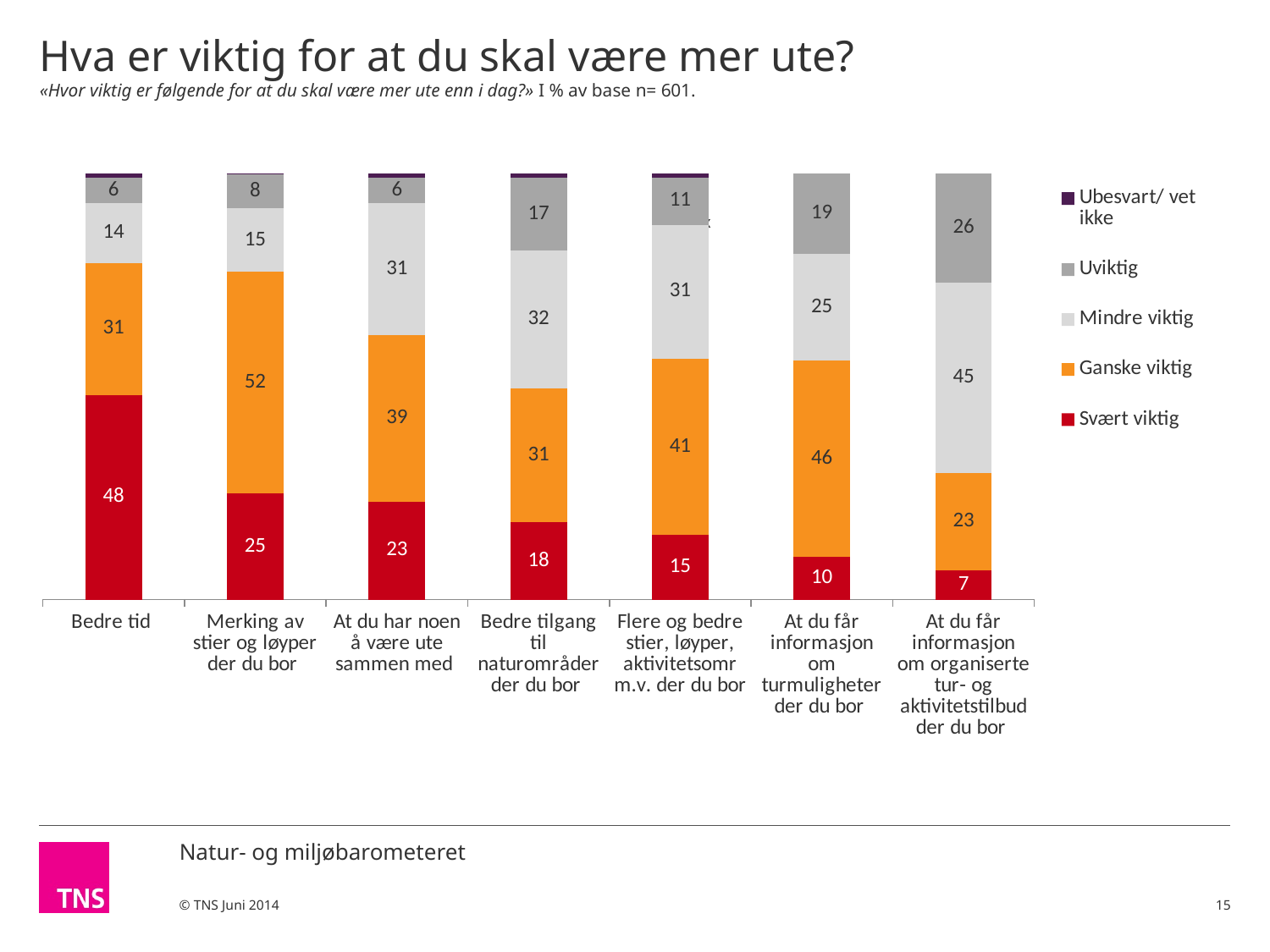
What is the difference between the 'Svært viktig' values for 'Bedre tid' and 'Merking av stier og løyper der du bor'? 23 Which series is shown in red in the legend? Svært viktig Which category has the highest 'Svært viktig' value? Bedre tid Which category has the lowest 'Svært viktig' value? At du får informasjon om organiserte tur- og aktivitetstilbud der du bor What kind of chart is shown on the slide? Stacked bar chart Which is larger: the 'Ganske viktig' value for 'Flere og bedre stier, løyper, aktivitetsomr m.v. der du bor' or for 'At du får informasjon om turmuligheter der du bor'? At du får informasjon om turmuligheter der du bor What is the 'Ganske viktig' value for 'Merking av stier og løyper der du bor'? 52 What is the 'Svært viktig' value for 'Bedre tid'? 48 What is the 'Mindre viktig' value for 'At du får informasjon om organiserte tur- og aktivitetstilbud der du bor'? 45 What is the 'Uviktig' value for 'At du får informasjon om turmuligheter der du bor'? 19 How many categories are shown along the x axis? 7 How many series does the legend list? 5